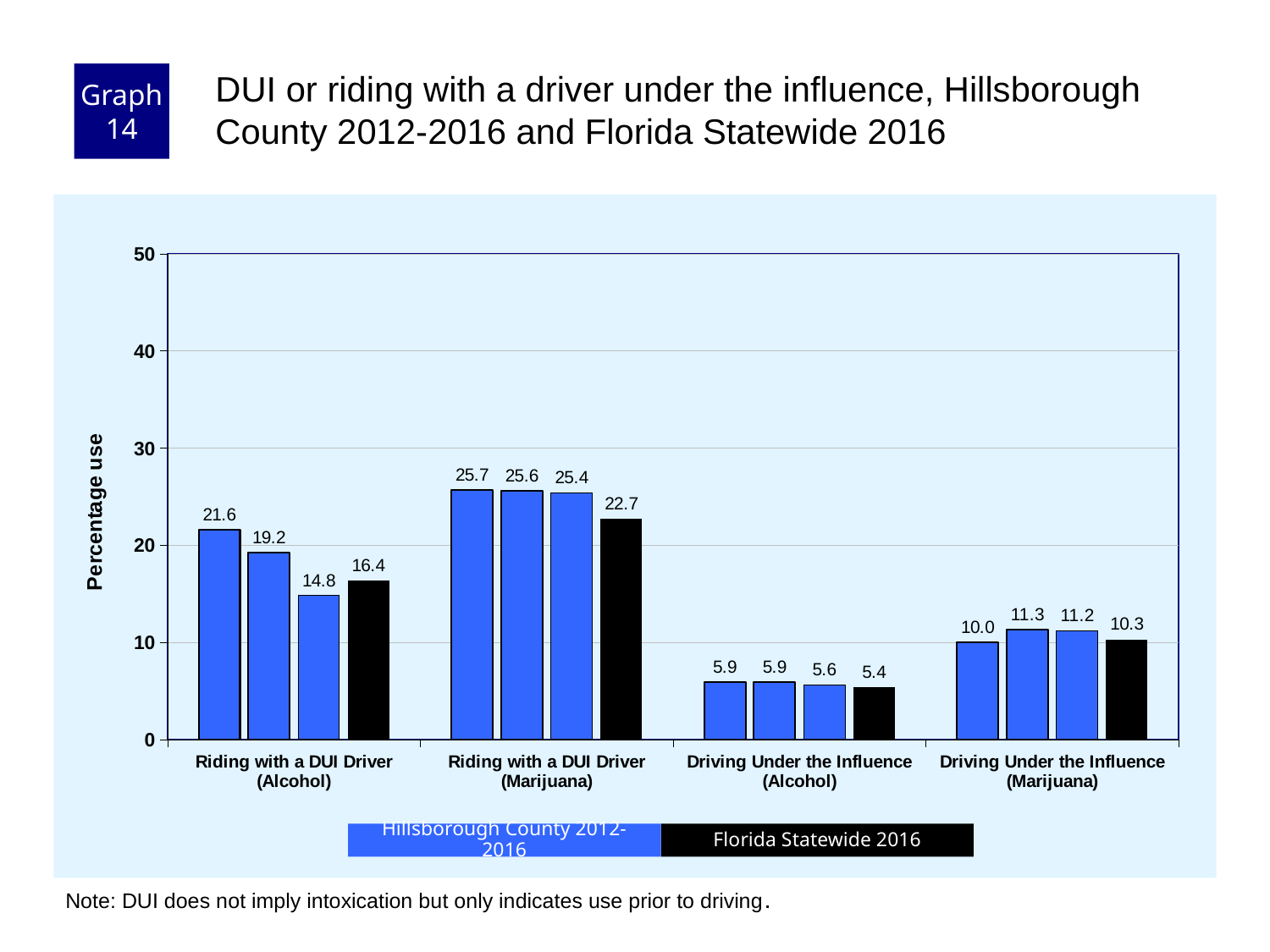
What is the Florida Statewide 2016 value for Riding with a DUI Driver (Alcohol)? 16.4 What is the lowest value shown on the chart? 5.4 Which category has the highest bar on the chart? Riding with a DUI Driver (Marijuana) How many series does the legend list? 2 How many categories are shown on the x axis? 4 What kind of chart is shown on the slide? bar chart What is the label on the y axis? Percentage use Is the Florida Statewide 2016 value for Riding with a DUI Driver (Marijuana) greater or less than 20? greater What is the Florida Statewide 2016 value for Driving Under the Influence (Marijuana)? 10.3 What is the difference between the Florida Statewide 2016 values for Riding with a DUI Driver (Marijuana) and Riding with a DUI Driver (Alcohol)? 6.3 What is the value of the first (leftmost) Hillsborough County bar for Riding with a DUI Driver (Alcohol)? 21.6 For Florida Statewide 2016, which is larger: Riding with a DUI Driver (Alcohol) or Driving Under the Influence (Marijuana)? Riding with a DUI Driver (Alcohol)